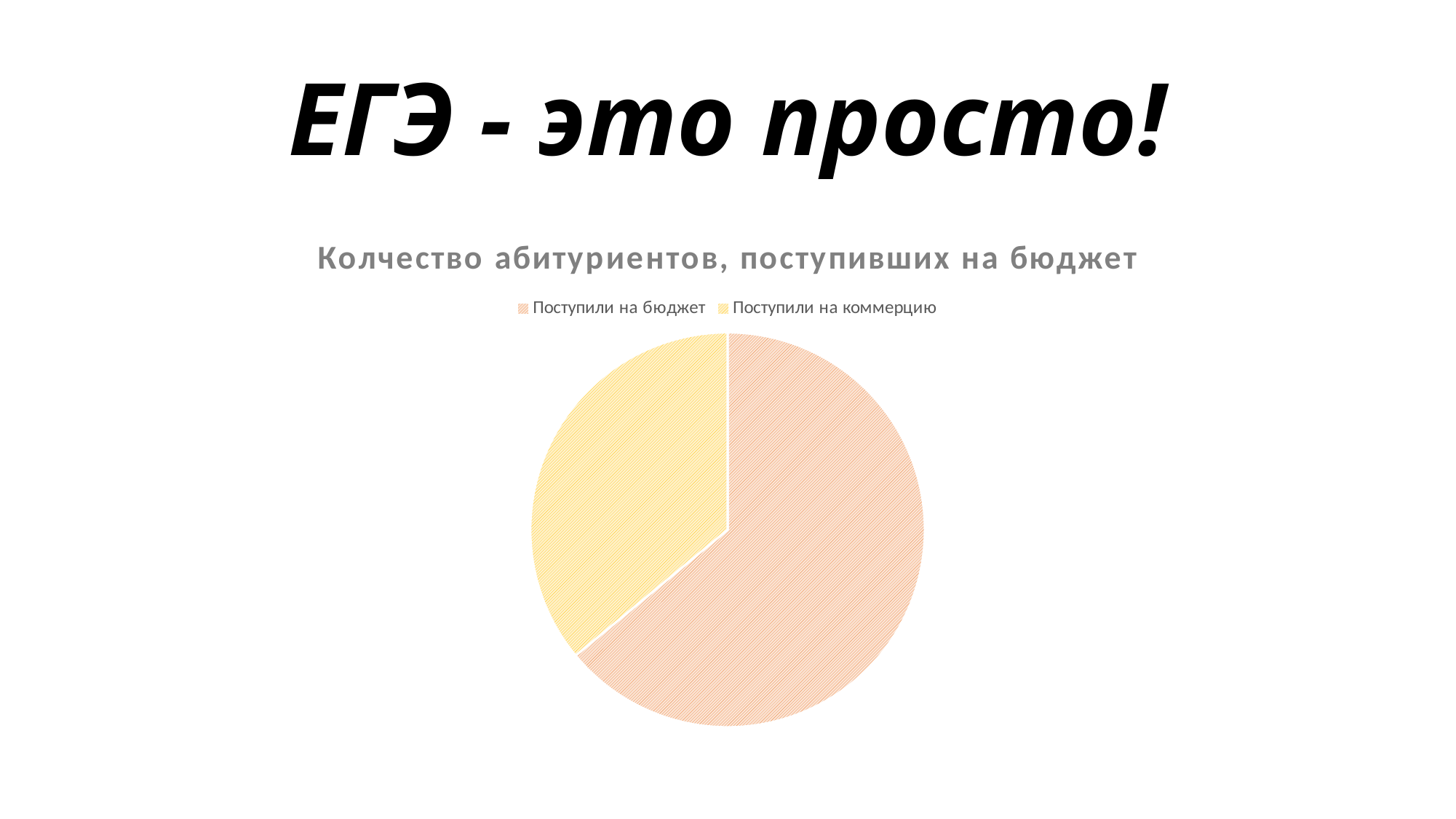
How many slices does the pie chart have? 2 Which slice of the pie chart is the largest? Поступили на бюджет Which slice of the pie chart is the smallest? Поступили на коммерцию How many entries does the legend of the pie chart list? 2 What is the title of the pie chart? Колчество абитуриентов, поступивших на бюджет What kind of chart is shown on the slide? pie chart Which is larger in the pie chart: Поступили на бюджет or Поступили на коммерцию? Поступили на бюджет Which legend entry is shown in yellow in the pie chart? Поступили на коммерцию